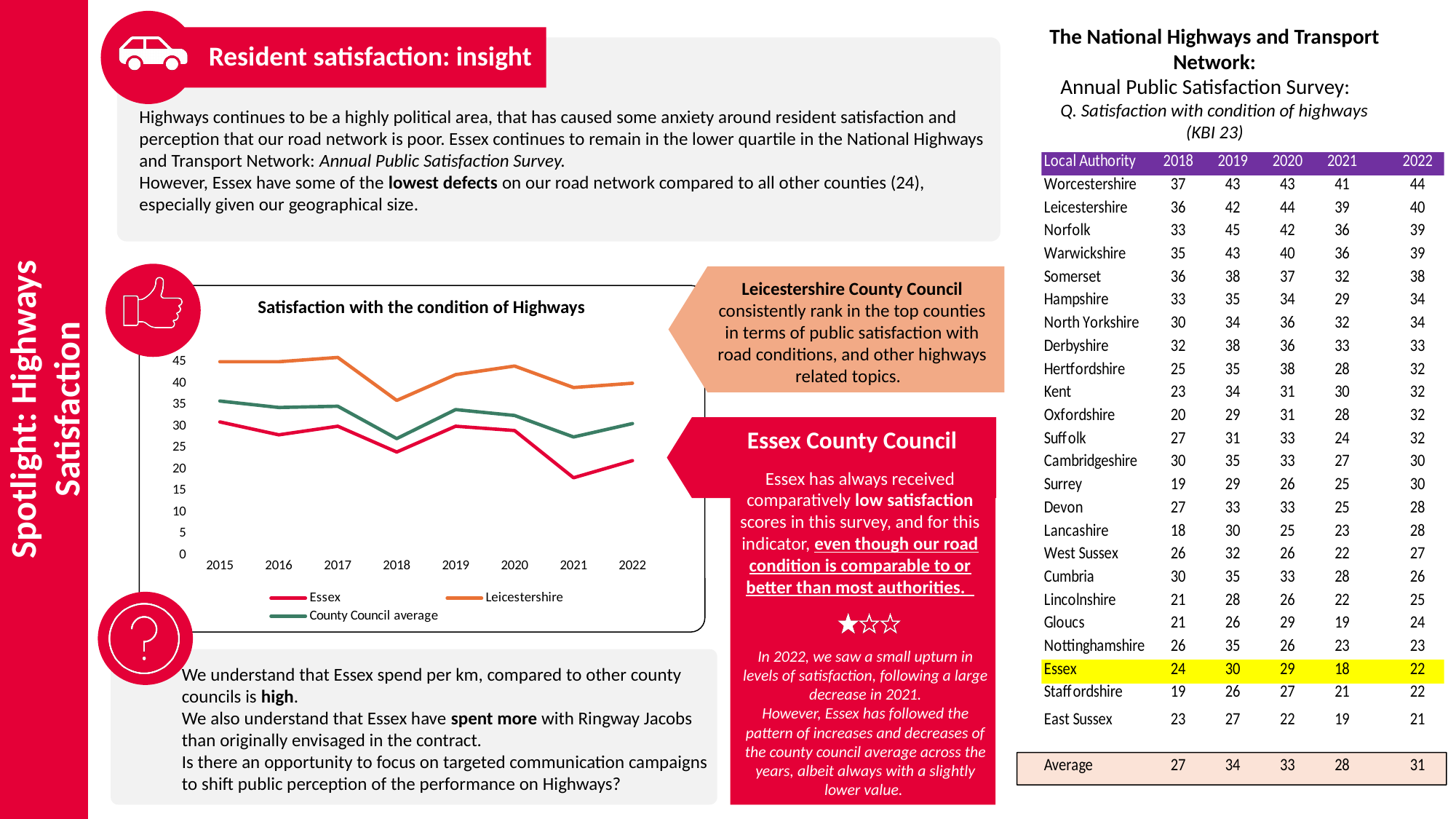
Is the value for Essex in 2021 greater or less than 20? less How many years are plotted along the x axis of the chart? 8 What kind of chart is shown on the slide? line chart In which year does the Leicestershire line reach its highest point? 2017 In which year does the Essex line reach its lowest point? 2021 Is the value for Leicestershire in 2018 greater or less than 40? less Does the Essex line rise or fall from 2020 to 2021? fall What is the title of the chart? Satisfaction with the condition of Highways Is the value for Leicestershire in 2020 greater or less than 40? greater Which series is drawn in orange in the chart? Leicestershire How many series does the chart legend list? 3 Which series has the higher value in 2019, Essex or Leicestershire? Leicestershire